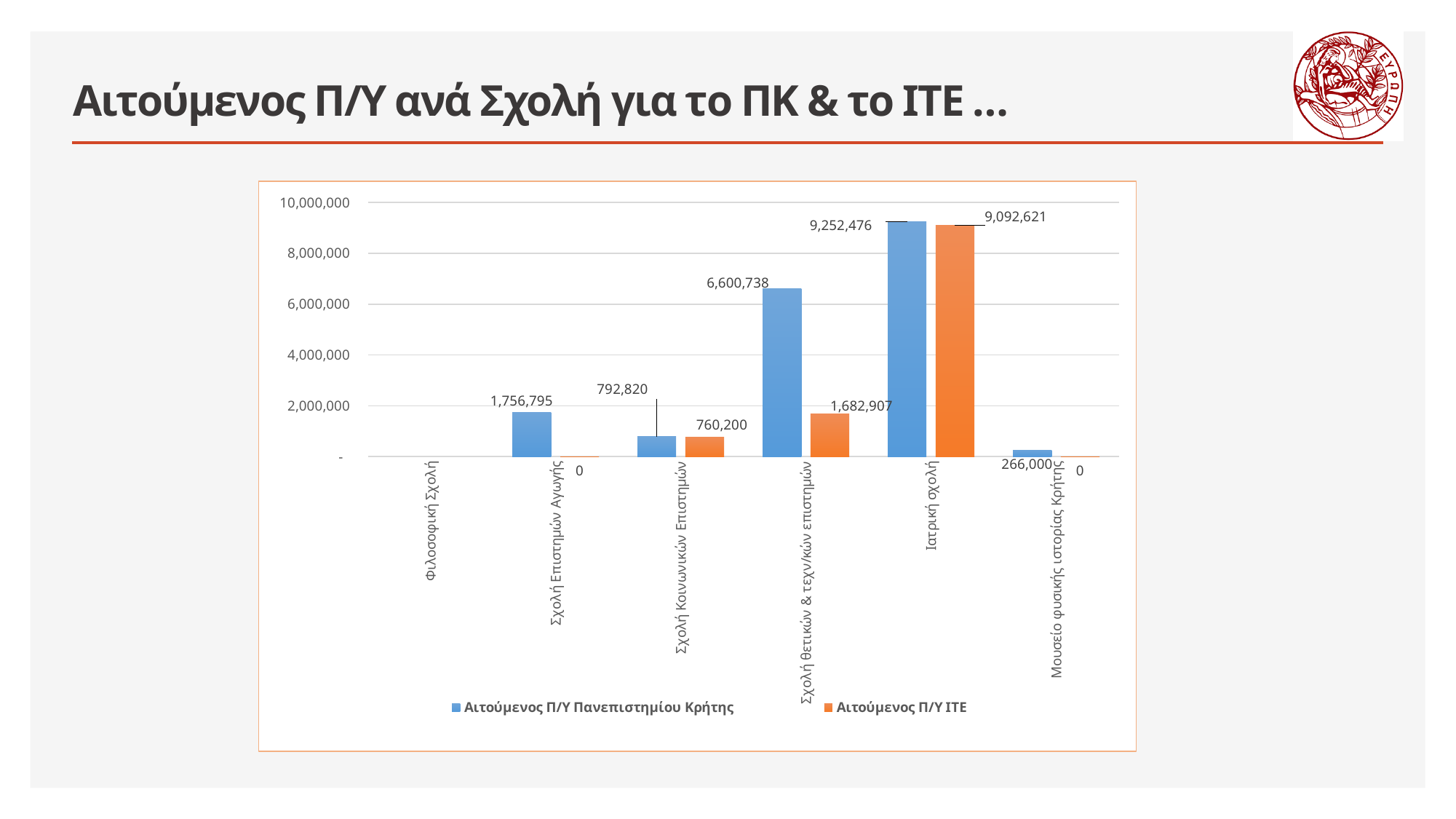
Which category has the highest value for Αιτούμενος Π/Υ Πανεπιστημίου Κρήτης? Ιατρική σχολή What is the value of Αιτούμενος Π/Υ ΙΤΕ for Ιατρική σχολή? 9,092,621 Which colour represents the Αιτούμενος Π/Υ ΙΤΕ series? orange What is the value of Αιτούμενος Π/Υ ΙΤΕ for Σχολή Κοινωνικών Επιστημών? 760,200 What is the value of Αιτούμενος Π/Υ Πανεπιστημίου Κρήτης for Σχολή θετικών & τεχν/κών επιστημών? 6,600,738 What is the value of Αιτούμενος Π/Υ Πανεπιστημίου Κρήτης for Ιατρική σχολή? 9,252,476 What is the value of Αιτούμενος Π/Υ ΙΤΕ for Σχολή Επιστημών Αγωγής? 0 What is the difference between Αιτούμενος Π/Υ Πανεπιστημίου Κρήτης and Αιτούμενος Π/Υ ΙΤΕ for Σχολή θετικών & τεχν/κών επιστημών? 4,917,831 How many categories are shown on the x axis? 6 What type of chart is shown on the slide? bar chart How many series does the legend list? 2 Which is larger for Σχολή Κοινωνικών Επιστημών: Αιτούμενος Π/Υ Πανεπιστημίου Κρήτης or Αιτούμενος Π/Υ ΙΤΕ? Αιτούμενος Π/Υ Πανεπιστημίου Κρήτης